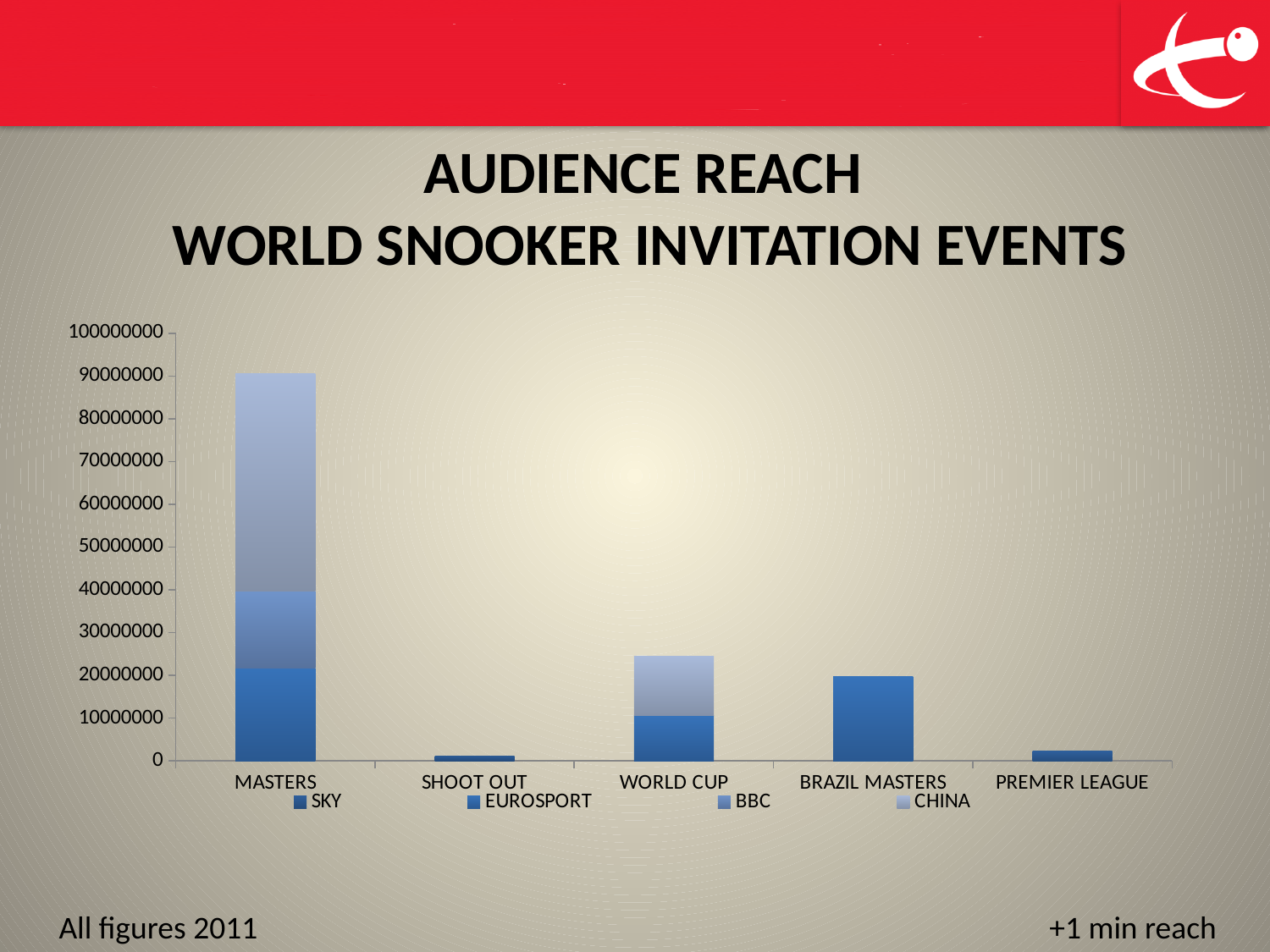
Is the total audience reach for SHOOT OUT greater or less than 10000000? less How many series does the chart's legend list? 4 Which event has the highest total audience reach? MASTERS Is the total audience reach for BRAZIL MASTERS greater or less than 30000000? less Is the total audience reach for WORLD CUP greater or less than 20000000? greater How many events are shown along the x axis of the chart? 5 What kind of chart is shown on the slide? Stacked bar chart Which has the larger total audience reach, MASTERS or WORLD CUP? MASTERS What is the title of the chart on the slide? AUDIENCE REACH WORLD SNOOKER INVITATION EVENTS Which has the larger total audience reach, WORLD CUP or BRAZIL MASTERS? WORLD CUP